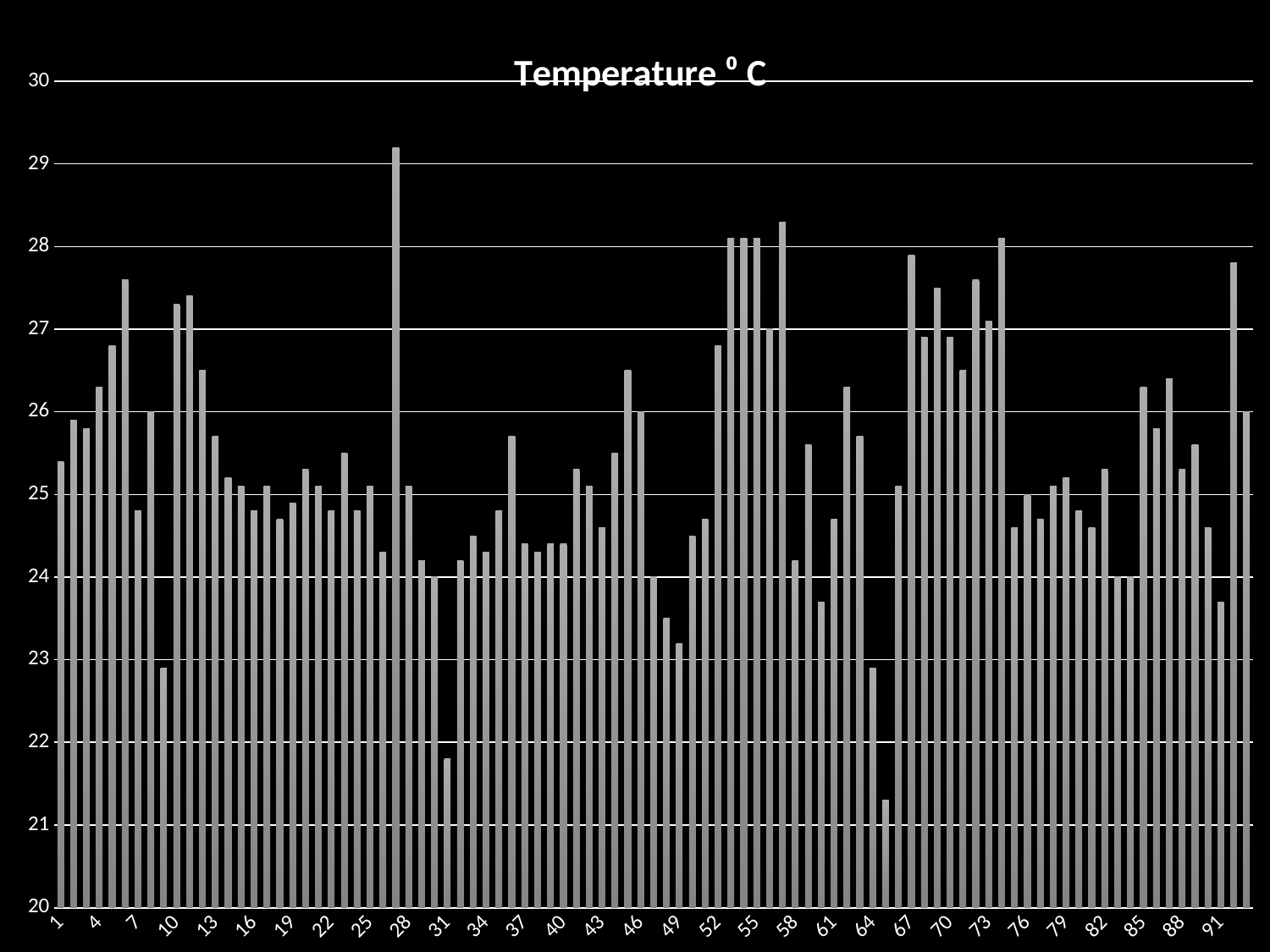
What kind of chart is shown on the slide? bar chart Is the lowest value on the chart greater or less than 22? less Is the value for category 4 greater or less than 26? greater Which category has the highest temperature? 27 Is the highest value on the chart greater or less than 29? greater What is the title of the chart? Temperature ⁰ C What colour are the bars in the chart? grey Which is larger, the value for category 4 or the value for category 7? category 4